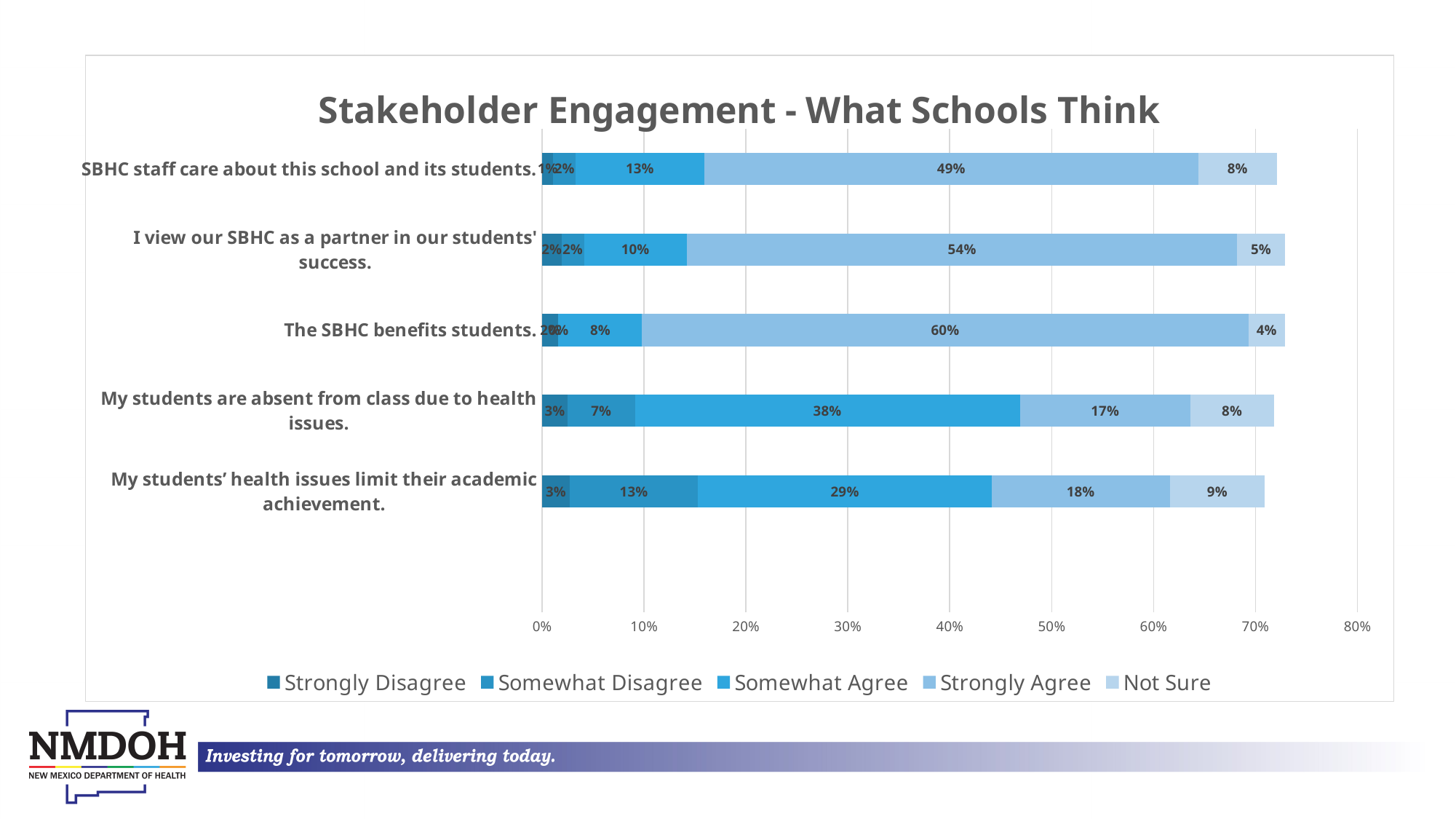
What is the Not Sure value for "My students' health issues limit their academic achievement."? 9% How many series does the legend list? 5 What is the title of the chart? Stakeholder Engagement - What Schools Think How many statements (categories) are plotted on the chart? 5 Which statement has the lowest Not Sure value? The SBHC benefits students. What is the total of the stacked bar for "My students are absent from class due to health issues."? 73% What is the Somewhat Agree value for "My students are absent from class due to health issues."? 38% What is the difference between the Strongly Agree values for "I view our SBHC as a partner in our students' success." and "SBHC staff care about this school and its students."? 5% What kind of chart is shown on the slide? Stacked bar chart What is the Strongly Agree value for "The SBHC benefits students."? 60% Which statement has the larger Somewhat Disagree value: "My students' health issues limit their academic achievement." or "My students are absent from class due to health issues."? My students' health issues limit their academic achievement. Which statement has the highest Strongly Agree value? The SBHC benefits students.